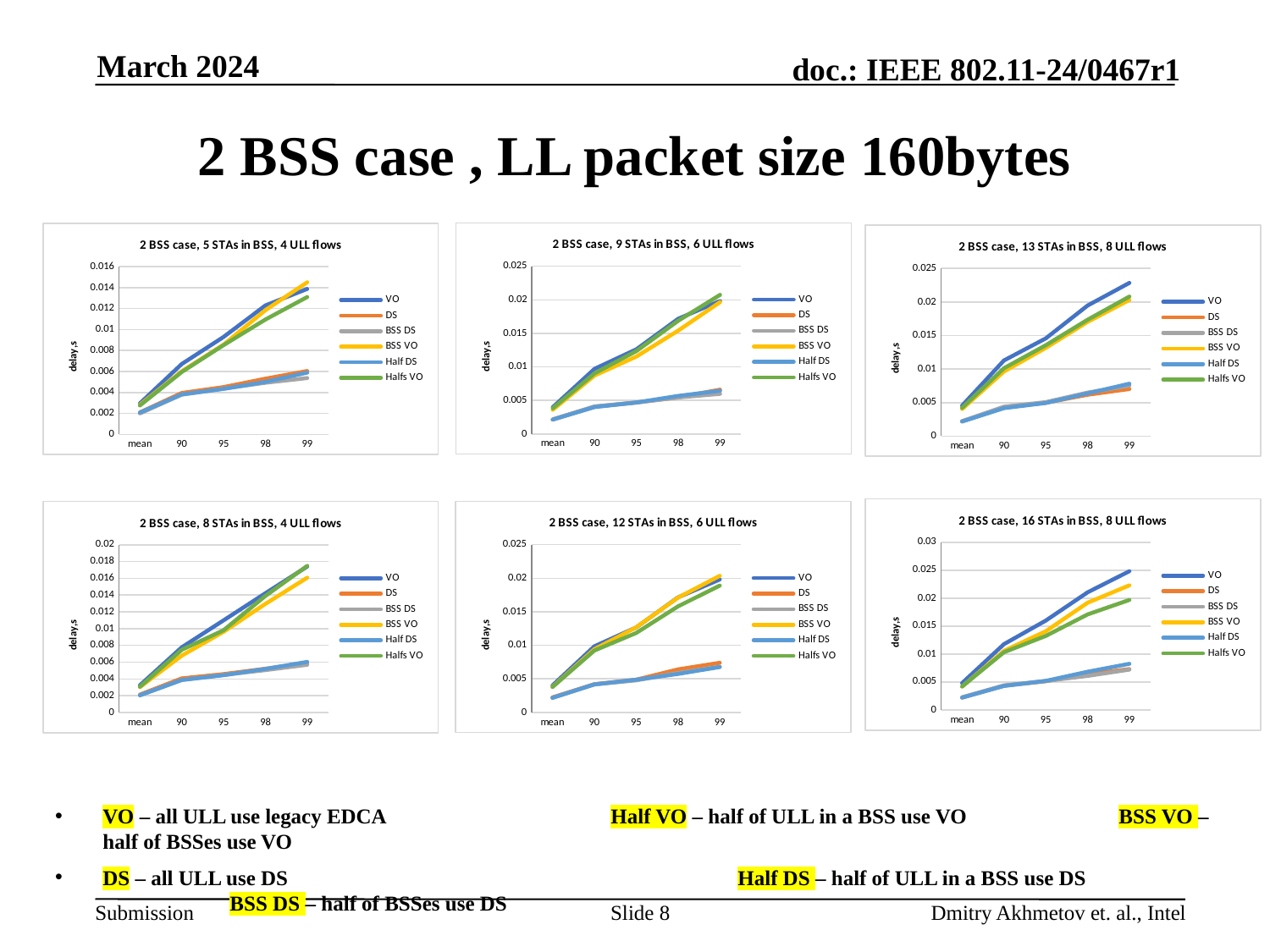
What is the y-axis label of the '2 BSS case, 12 STAs in BSS, 6 ULL flows' chart? delay,s In the '2 BSS case, 16 STAs in BSS, 8 ULL flows' chart, does the VO series rise or fall from mean to 99? rise What kind of chart is the '2 BSS case, 5 STAs in BSS, 4 ULL flows' chart? line chart What is the title of the top-left chart on the slide? 2 BSS case, 5 STAs in BSS, 4 ULL flows In the '2 BSS case, 8 STAs in BSS, 4 ULL flows' chart, is the DS value at 99 greater or less than 0.01? less In the '2 BSS case, 5 STAs in BSS, 4 ULL flows' chart, which is larger at 99, VO or DS? VO In the '2 BSS case, 13 STAs in BSS, 8 ULL flows' chart, is the VO value at 99 greater or less than 0.02? greater How many series does the legend of the '2 BSS case, 9 STAs in BSS, 6 ULL flows' chart list? 6 In the '2 BSS case, 16 STAs in BSS, 8 ULL flows' chart, is the VO value at 99 greater or less than 0.02? greater How many categories are on the x axis of the '2 BSS case, 13 STAs in BSS, 8 ULL flows' chart? 5 In the '2 BSS case, 9 STAs in BSS, 6 ULL flows' chart, which is larger at 95, Halfs VO or Half DS? Halfs VO